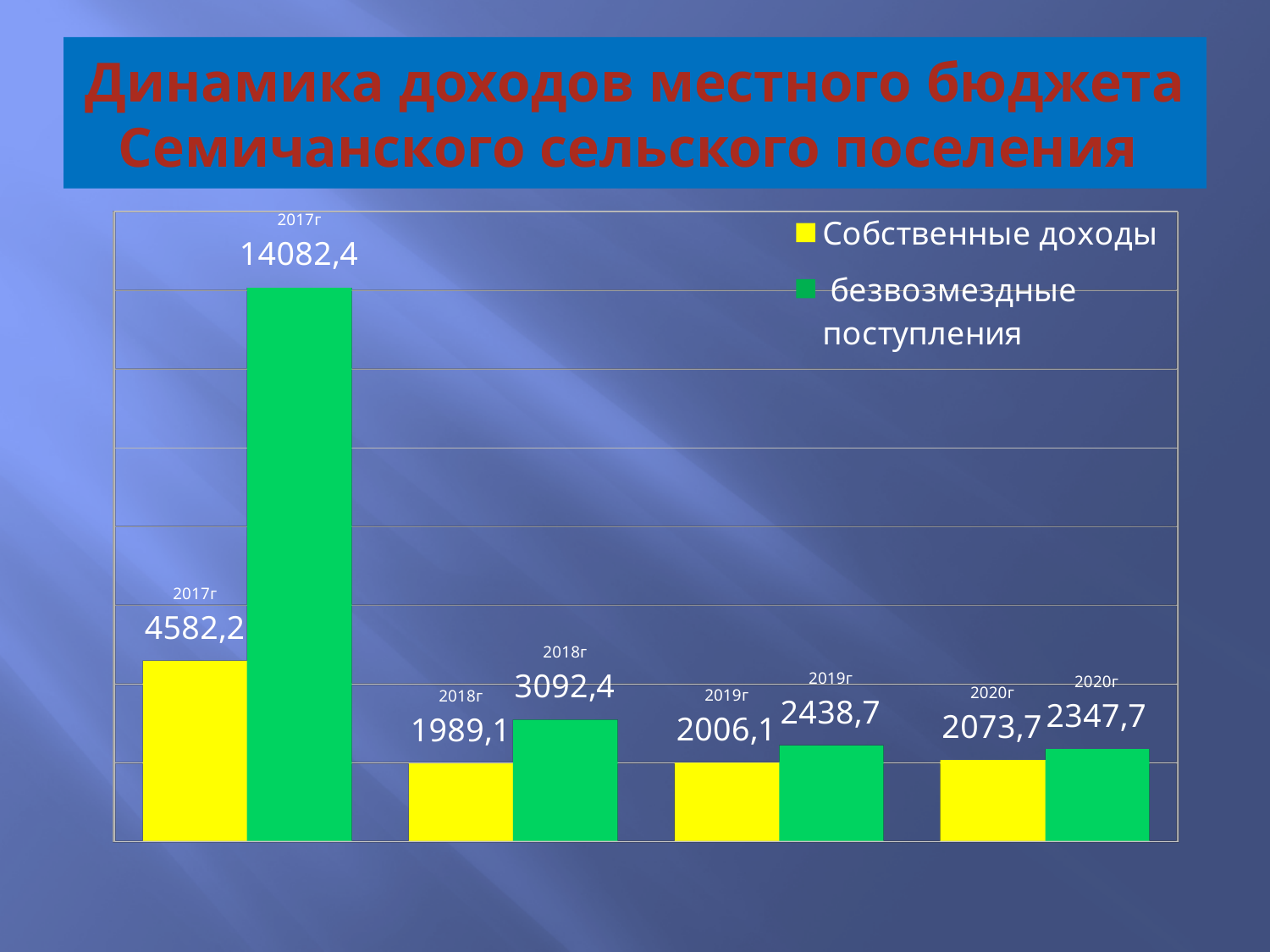
How many years are shown on the chart? 4 What is the value of Собственные доходы for 2017г? 4582,2 What is the value of безвозмездные поступления for 2019г? 2438,7 What is the value of Собственные доходы for 2020г? 2073,7 Which is larger in 2020г: Собственные доходы or безвозмездные поступления? безвозмездные поступления In which year is Собственные доходы lowest? 2018г What is the difference between безвозмездные поступления and Собственные доходы in 2019г? 432,6 What is the value of Собственные доходы for 2018г? 1989,1 In which year is безвозмездные поступления highest? 2017г What is the value of безвозмездные поступления for 2017г? 14082,4 Does безвозмездные поступления rise or fall from 2017г to 2020г? fall How many series does the legend list? 2